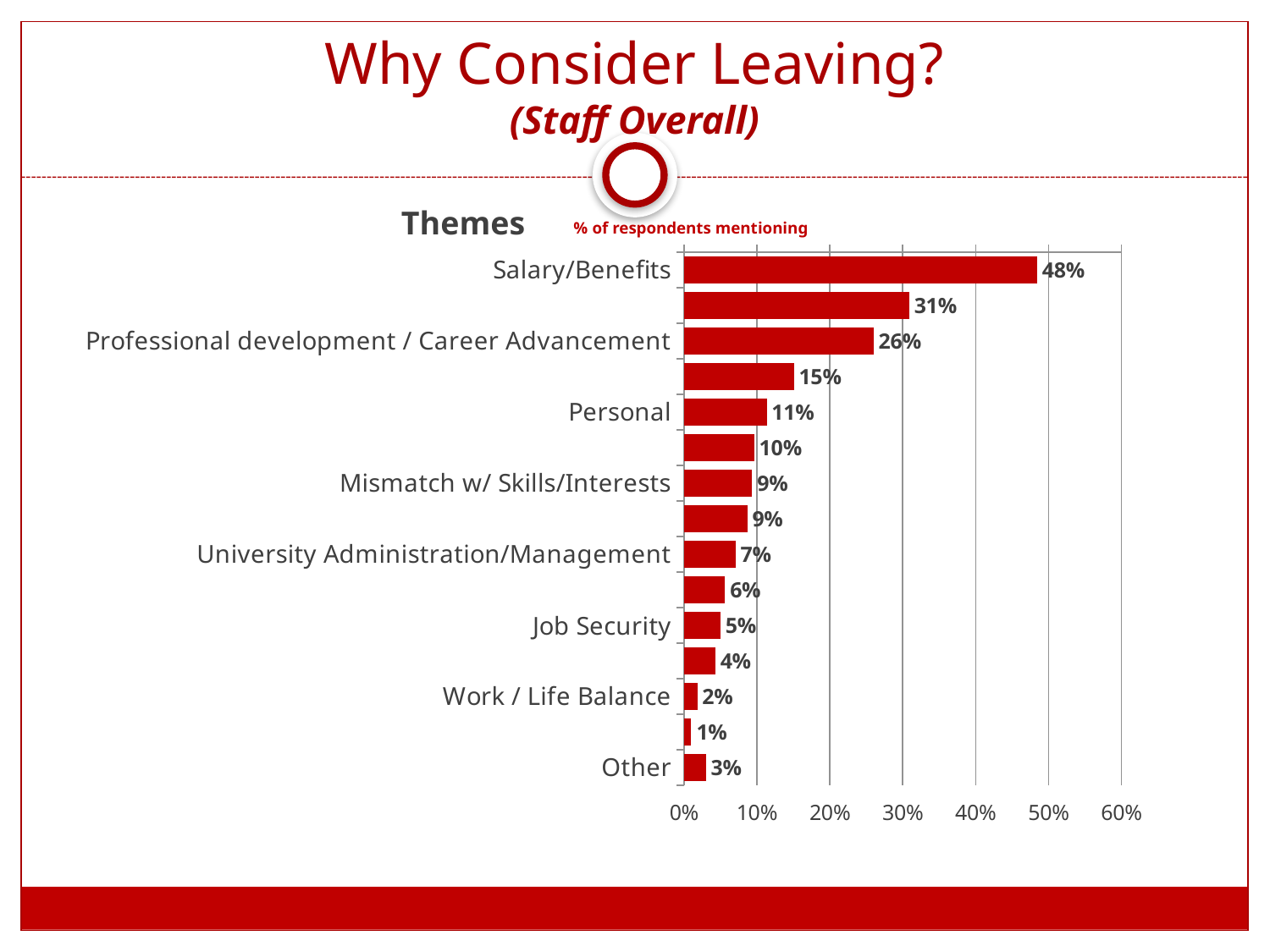
What is the difference between the values for Salary/Benefits and Professional development / Career Advancement? 22% What percentage of respondents mentioned Job Security? 5% Which theme has the highest percentage of respondents mentioning it? Salary/Benefits What is the label of the horizontal axis measure shown above the chart? % of respondents mentioning How many bars are plotted in the chart? 15 Which is larger, the value for Personal or the value for Mismatch w/ Skills/Interests? Personal Is the value for University Administration/Management greater or less than 10%? less What is the value for Work / Life Balance? 2% What is the value for Professional development / Career Advancement? 26% What percentage of respondents mentioned Salary/Benefits as a reason for considering leaving? 48% What is the smallest value labeled on any bar in the chart? 1% What type of chart is shown on the slide? Bar chart